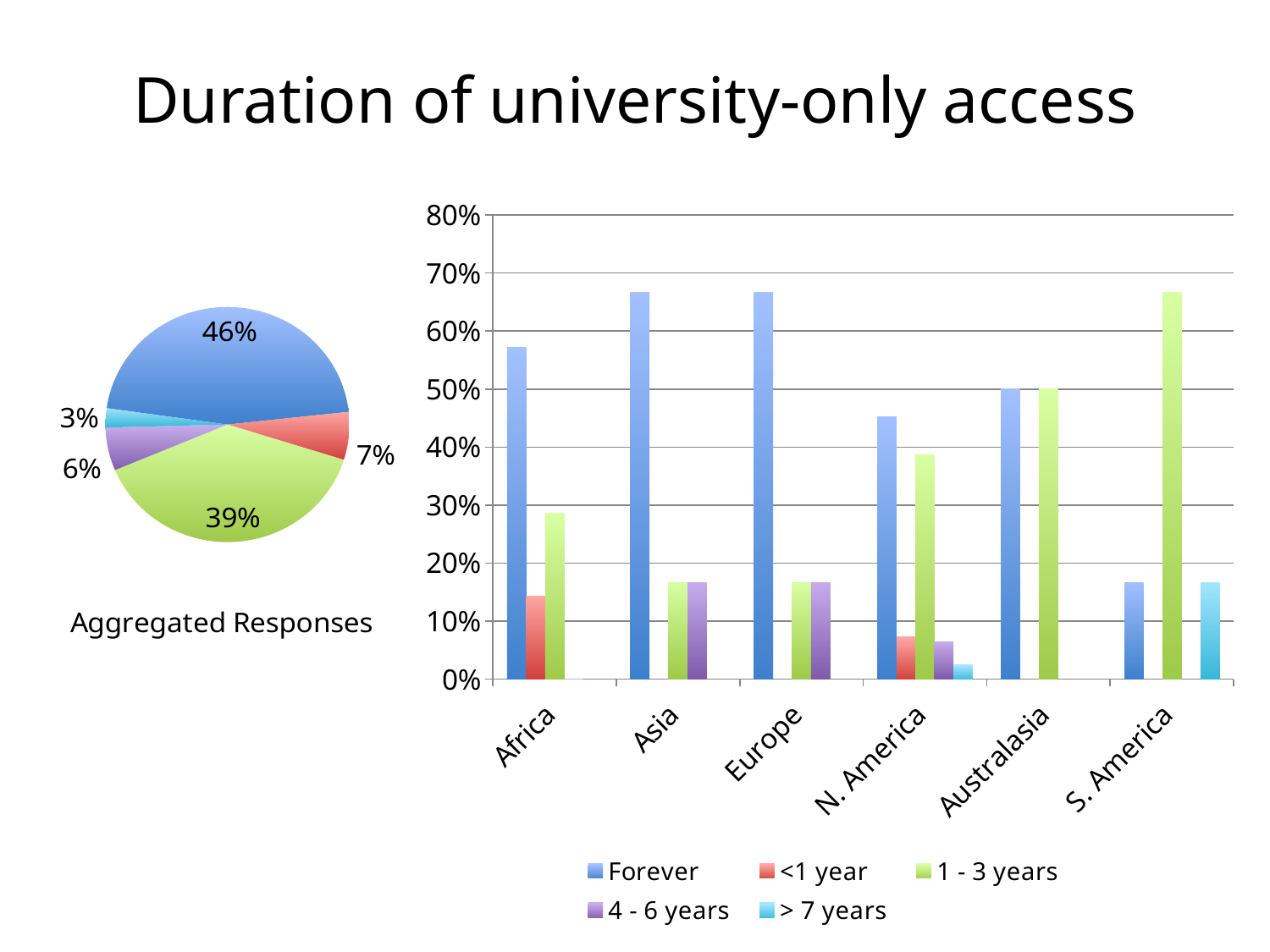
In the bar chart, which region has the higher 'Forever' value, Africa or Europe? Europe In the 'Aggregated Responses' pie chart, what is the share of the largest slice? 46% In the bar chart, is the 'Forever' value for Asia greater or less than 60%? greater In the bar chart, is the '1 - 3 years' value for S. America greater or less than 60%? greater In the bar chart, which series is shown in green in the legend? 1 - 3 years In the bar chart, how many series does the legend list? 5 In the bar chart, is the 'Forever' value for N. America greater or less than 50%? less In the 'Aggregated Responses' pie chart, what is the difference between the 46% slice and the 39% slice? 7% What kind of chart is the 'Aggregated Responses' chart on the left? pie chart In the 'Aggregated Responses' pie chart, what is the share of the smallest slice? 3% In the bar chart, how many regions are shown on the x axis? 6 What kind of chart is the chart on the right of the slide? bar chart